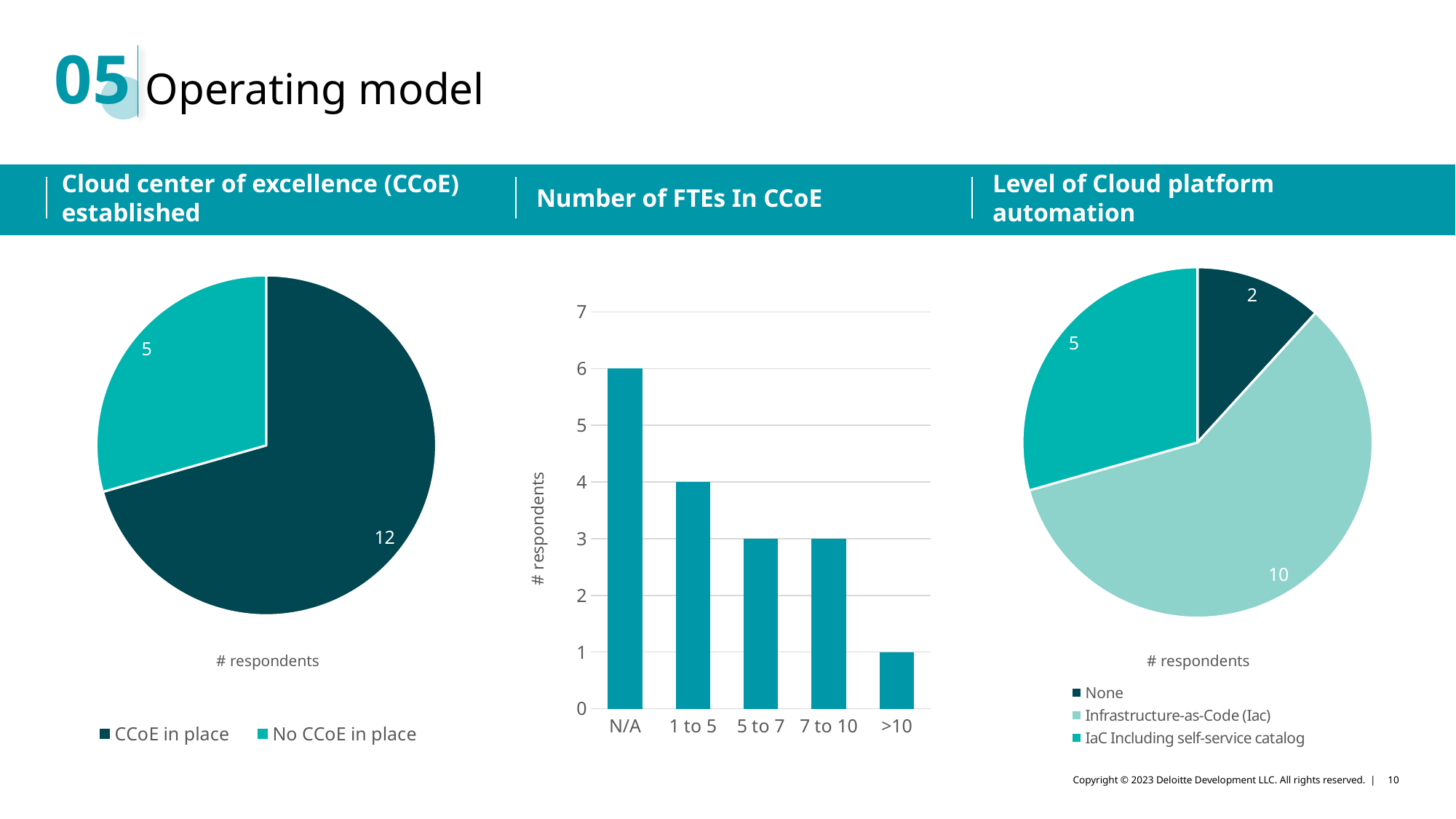
How many entries does the legend of the 'Level of Cloud platform automation' pie chart list? 3 In the 'Number of FTEs In CCoE' chart, how many respondents reported 1 to 5 FTEs? 4 In the 'Number of FTEs In CCoE' chart, how many categories are shown on the x axis? 5 In the 'Level of Cloud platform automation' pie chart, how many respondents selected Infrastructure-as-Code (Iac)? 10 What type of chart is the 'Number of FTEs In CCoE' chart? Bar chart In the 'Number of FTEs In CCoE' chart, which category has the highest number of respondents? N/A In the 'Cloud center of excellence (CCoE) established' pie chart, how many respondents have a CCoE in place? 12 In the 'Cloud center of excellence (CCoE) established' pie chart, what is the difference between the number of respondents with a CCoE in place and those with no CCoE in place? 7 In the 'Number of FTEs In CCoE' chart, which category has the lowest number of respondents? >10 In the 'Level of Cloud platform automation' pie chart, which category has the fewest respondents? None In the 'Cloud center of excellence (CCoE) established' pie chart, how many respondents have no CCoE in place? 5 In the 'Number of FTEs In CCoE' chart, how many respondents answered N/A? 6